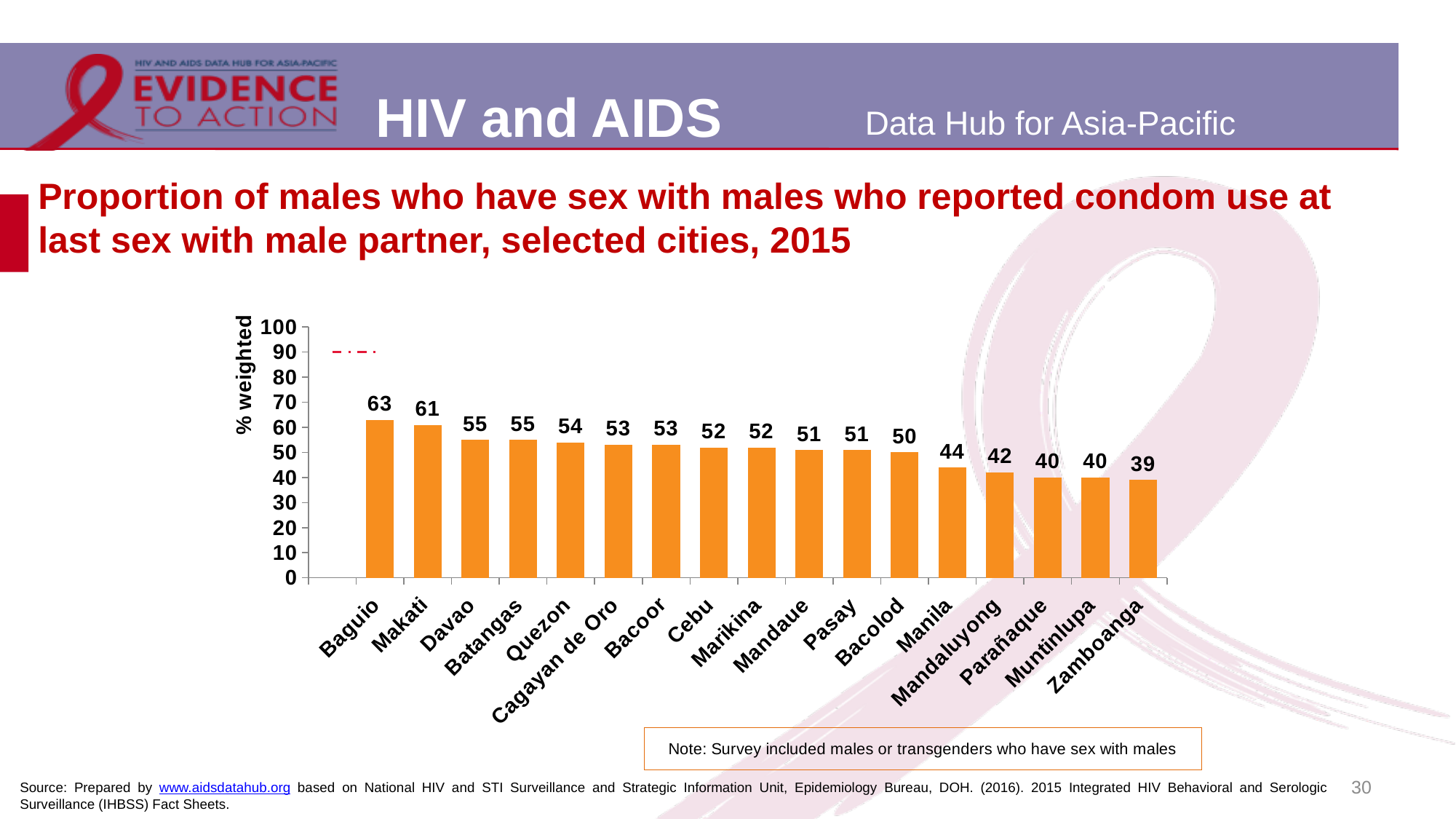
What is the value for Cagayan de Oro? 53 What is the label on the vertical axis? % weighted Which city has the highest value? Baguio What kind of chart is this? Bar chart What is the value for Baguio? 63 Do the values rise or fall from left to right along the x axis? Fall Which city has the lowest value? Zamboanga Which is larger, the value for Davao or the value for Bacolod? Davao What is the value for Manila? 44 How many cities are shown on the chart? 17 What is the difference between the values for Baguio and Zamboanga? 24 What is the difference between the values for Makati and Manila? 17